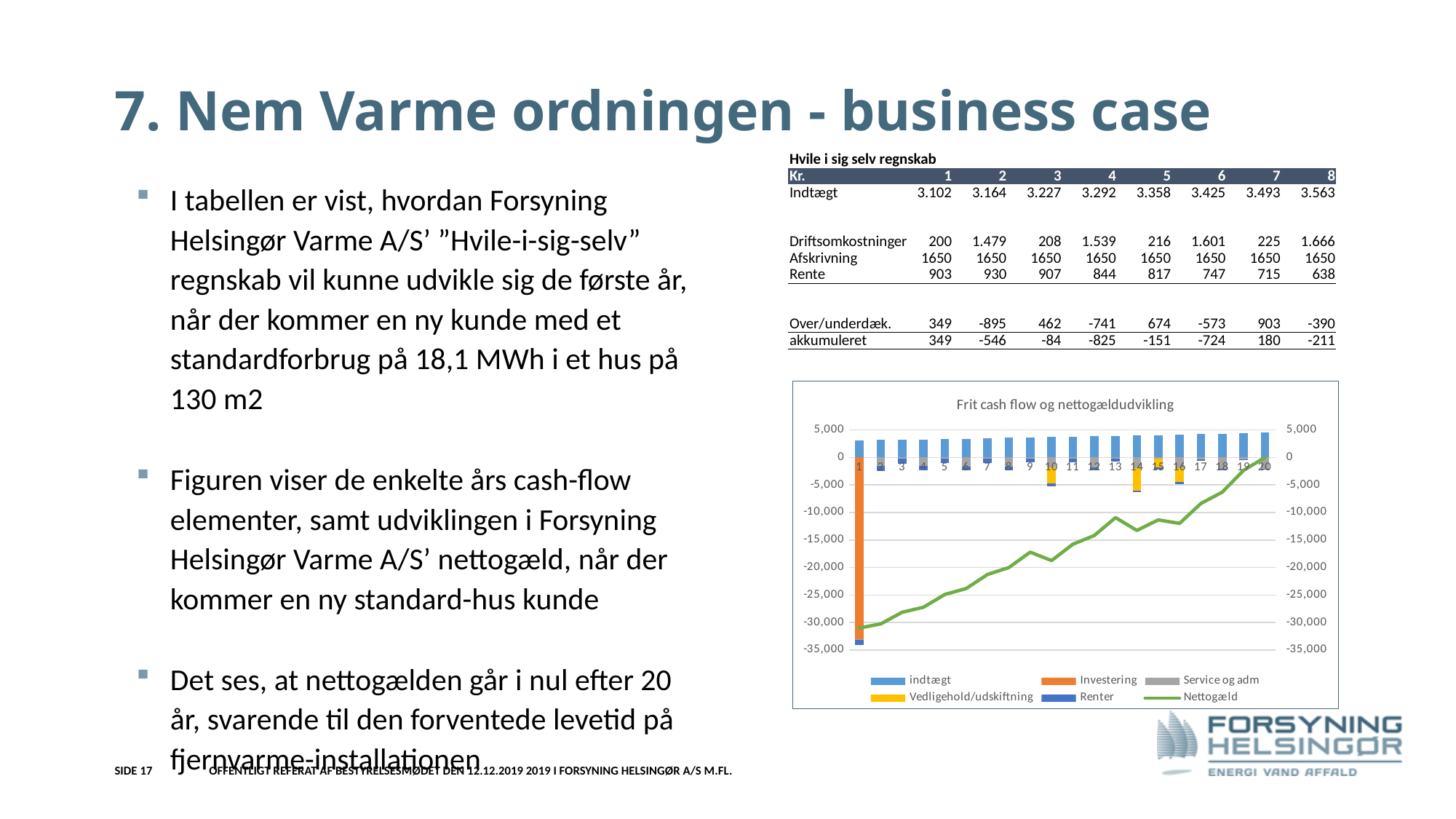
What kind of chart is "Frit cash flow og nettogældudvikling"? Combined bar and line chart Does the Nettogæld line rise or fall from year 1 to year 20? Rises How many years (points) are shown along the x axis of the chart? 20 What is the title of the chart on the slide? Frit cash flow og nettogældudvikling In which year is the Investering bar the largest (most negative)? 1 Is the Nettogæld value in year 5 greater or less than -20,000? less Is the Investering value in year 1 greater or less than -30,000? less Is the Nettogæld value in year 10 greater or less than -15,000? less How many series does the legend of the chart list? 6 Which colour represents Nettogæld in the chart legend? Green